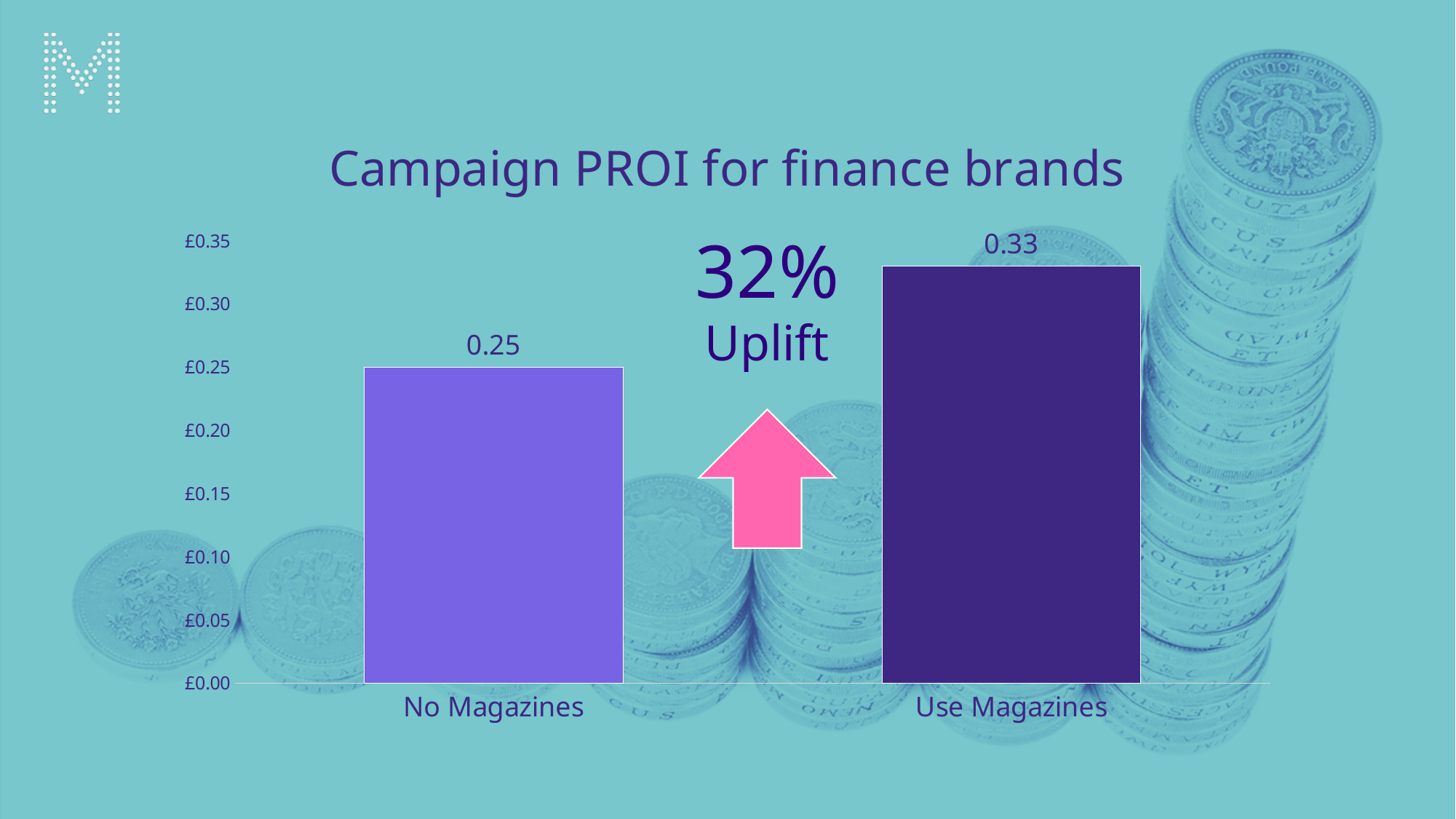
What is the title of the chart? Campaign PROI for finance brands Which category has the highest value? Use Magazines What kind of chart is shown on the slide? bar chart Which is larger, the value for No Magazines or the value for Use Magazines? Use Magazines Is the value for No Magazines greater or less than £0.30? less What is the value for Use Magazines? 0.33 Is the value for Use Magazines greater or less than £0.30? greater How many categories are shown on the chart? 2 What is the difference between the values for Use Magazines and No Magazines? 0.08 Which category has the lowest value? No Magazines What is the value for No Magazines? 0.25 What percentage uplift is annotated between the two bars? 32%